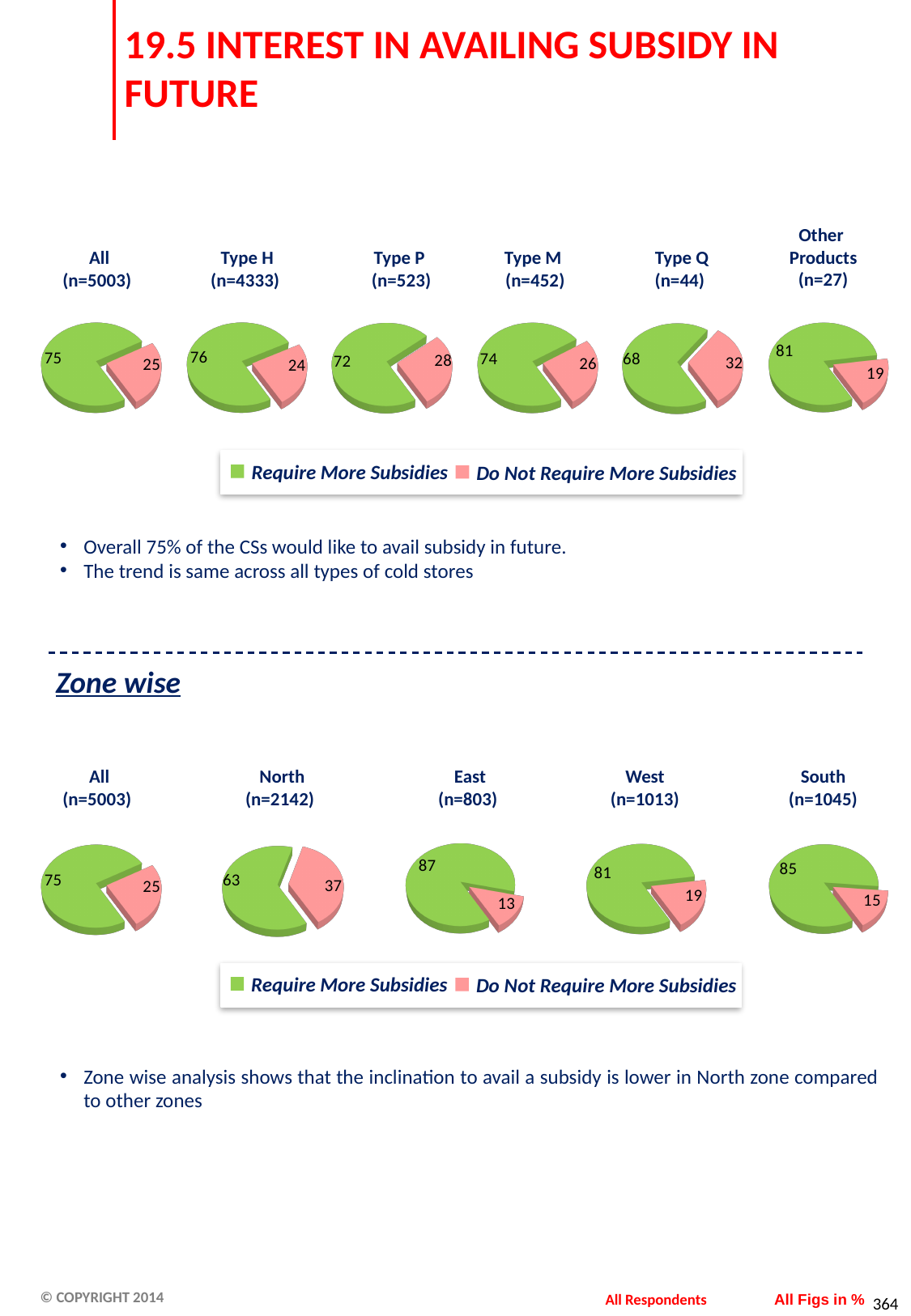
In the Zone wise row, what is the difference between the Require More Subsidies values for East and North? 24 In the Zone wise row of pie charts, what is the value for Do Not Require More Subsidies in the North (n=2142) pie? 37 In the top row of pie charts, what is the value for Do Not Require More Subsidies in the Type Q (n=44) pie? 32 What kind of chart is used to show the All (n=5003) data at the top of the slide? Pie chart Among the top row of pie charts, which pie has the highest value for Require More Subsidies? Other Products (n=27) In the Zone wise row of pie charts, what is the value for Require More Subsidies in the East (n=803) pie? 87 In the top row, which is larger: the Do Not Require More Subsidies value for Type P or for Type M? Type P How many pie charts are in the Zone wise row? 5 In the top row of pie charts, what is the value for Require More Subsidies in the Type H (n=4333) pie? 76 Among the Zone wise pie charts, which zone has the lowest value for Require More Subsidies? North (n=2142) How many series does the legend below the top row of pie charts list? 2 In the legend below the Zone wise pie charts, which colour represents Do Not Require More Subsidies? Pink